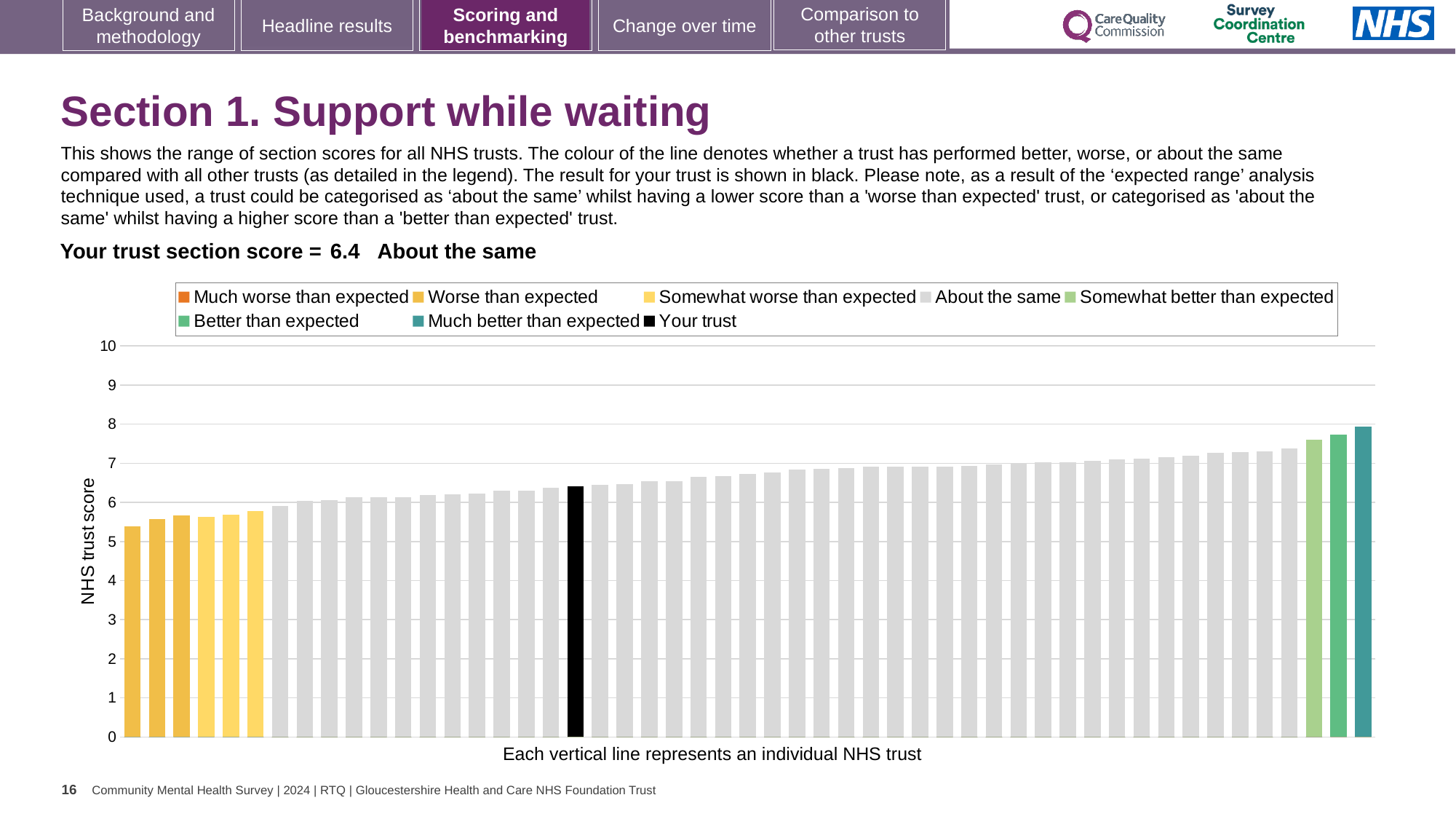
What is the section score for your trust shown on the slide? 6.4 Do the bar values rise or fall from left to right along the x axis? rise What colour is the bar representing your trust? black How many entries does the chart legend list? 8 Is the value of the shortest bar (leftmost) greater or less than 5? greater Which legend category does the tallest bar on the chart belong to? Much better than expected What is the label on the vertical axis of the chart? NHS trust score Which legend category do the shortest bars on the left of the chart belong to? Worse than expected Is the value of the shortest bar (leftmost) greater or less than 6? less Is the value of the black 'Your trust' bar greater or less than 6? greater What kind of chart is shown on the slide? bar chart